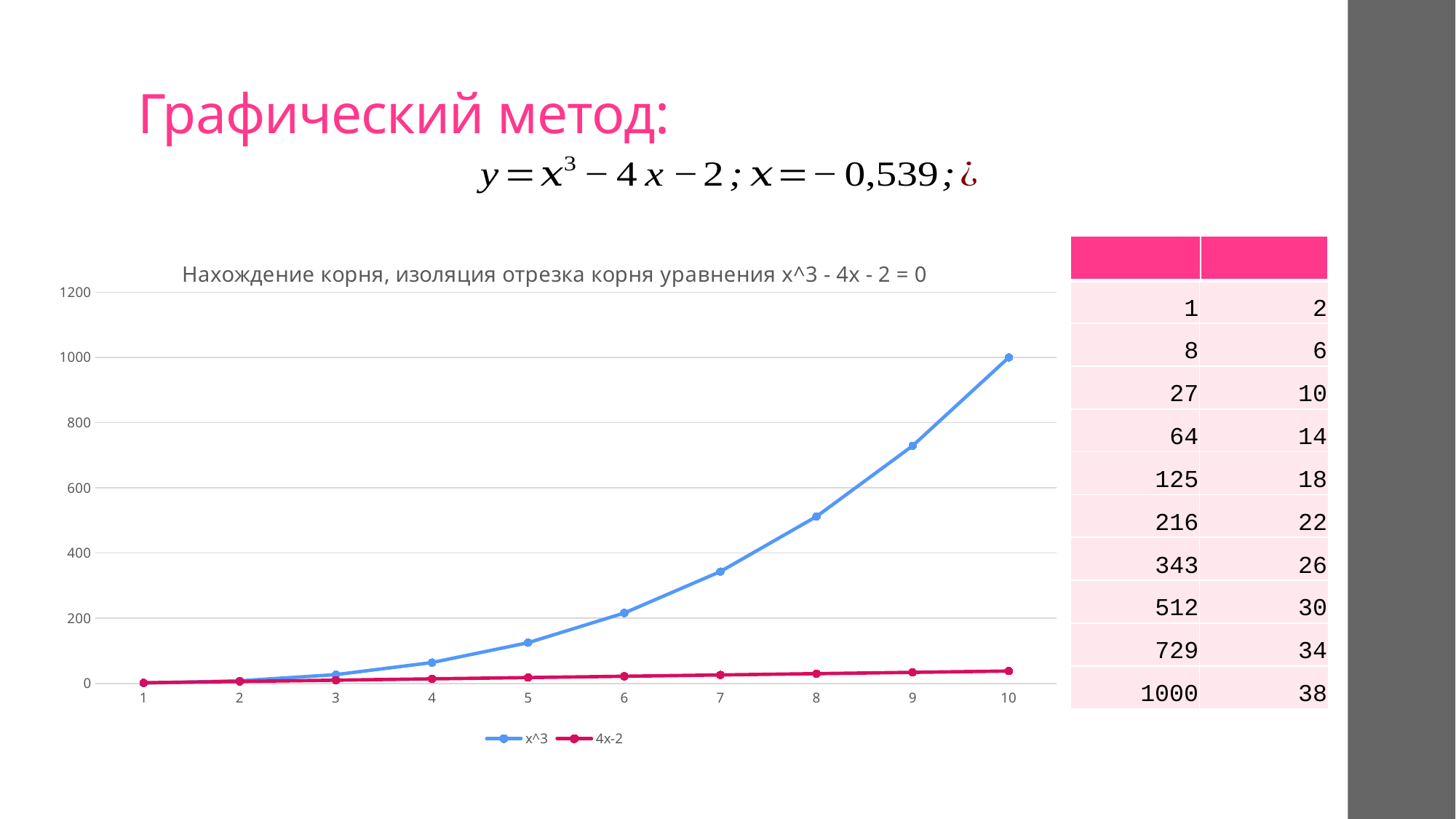
At which x value does the x^3 series reach its highest point? 10 What colour is the line for the x^3 series? blue Is the value of the x^3 series at x = 9 greater or less than 600? greater At x = 9, which series has the higher value, x^3 or 4x-2? x^3 Is the value of the x^3 series at x = 8 greater or less than 400? greater What kind of chart is shown on the slide? line chart Is the value of the x^3 series at x = 6 greater or less than 400? less Does the x^3 series rise or fall as x increases from 1 to 10? rises What is the value of the x^3 series at x = 10? 1000 How many x-axis points are plotted on the chart? 10 How many series does the chart legend list? 2